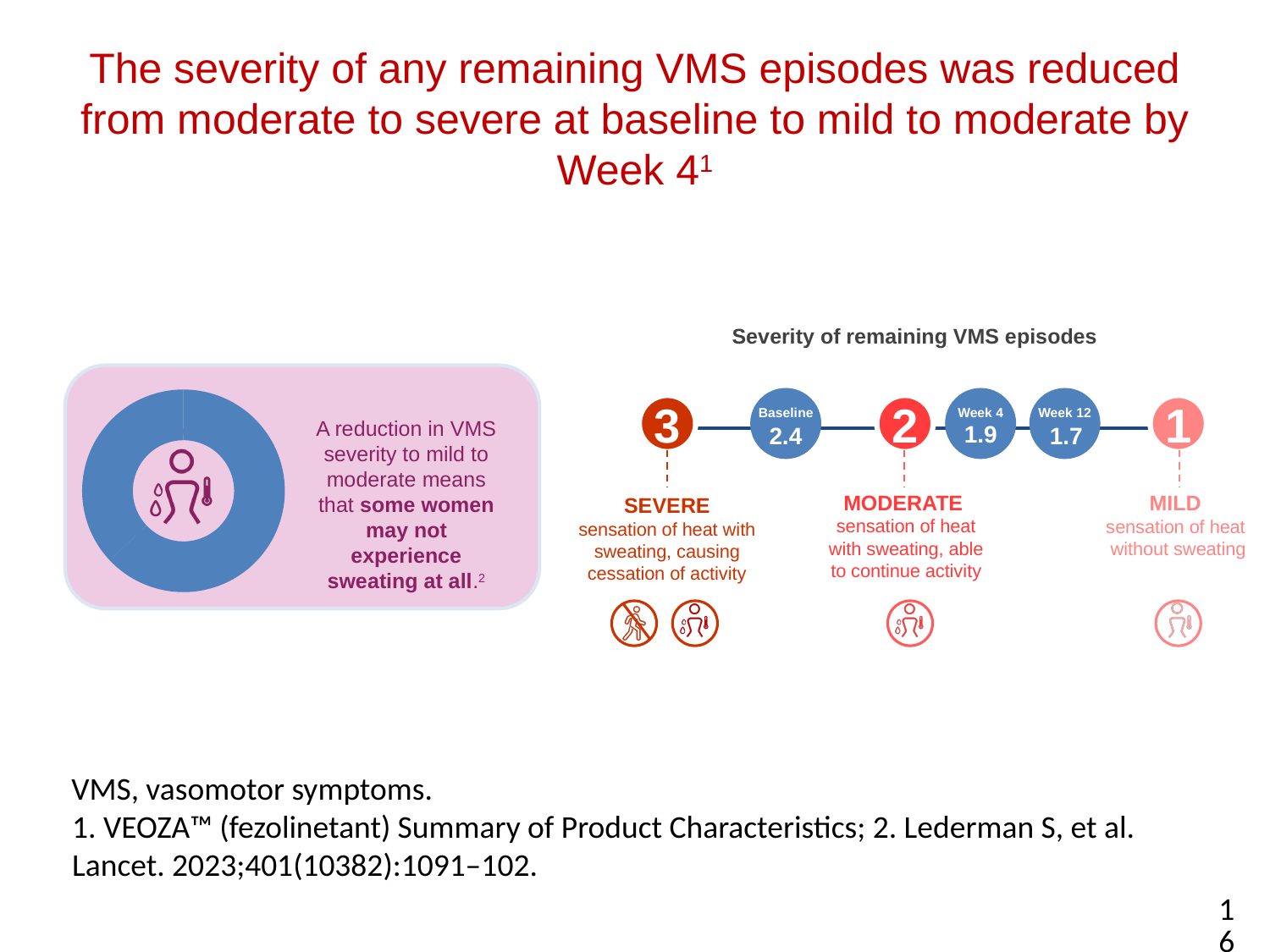
How many time points are plotted on the severity scale? 3 What is the severity score at Week 12? 1.7 Which time point has the lowest severity score? Week 12 Is the severity score at Week 4 greater or less than 2? less Do the severity scores rise or fall from Baseline to Week 12? fall Which time point has the highest severity score? Baseline What is the difference between the Baseline score and the Week 4 score? 0.5 What is the severity score at Baseline on the 'Severity of remaining VMS episodes' scale? 2.4 What is the difference between the Baseline score and the Week 12 score? 0.7 What is the severity score at Week 4? 1.9 Which is larger, the severity score at Baseline or at Week 12? Baseline